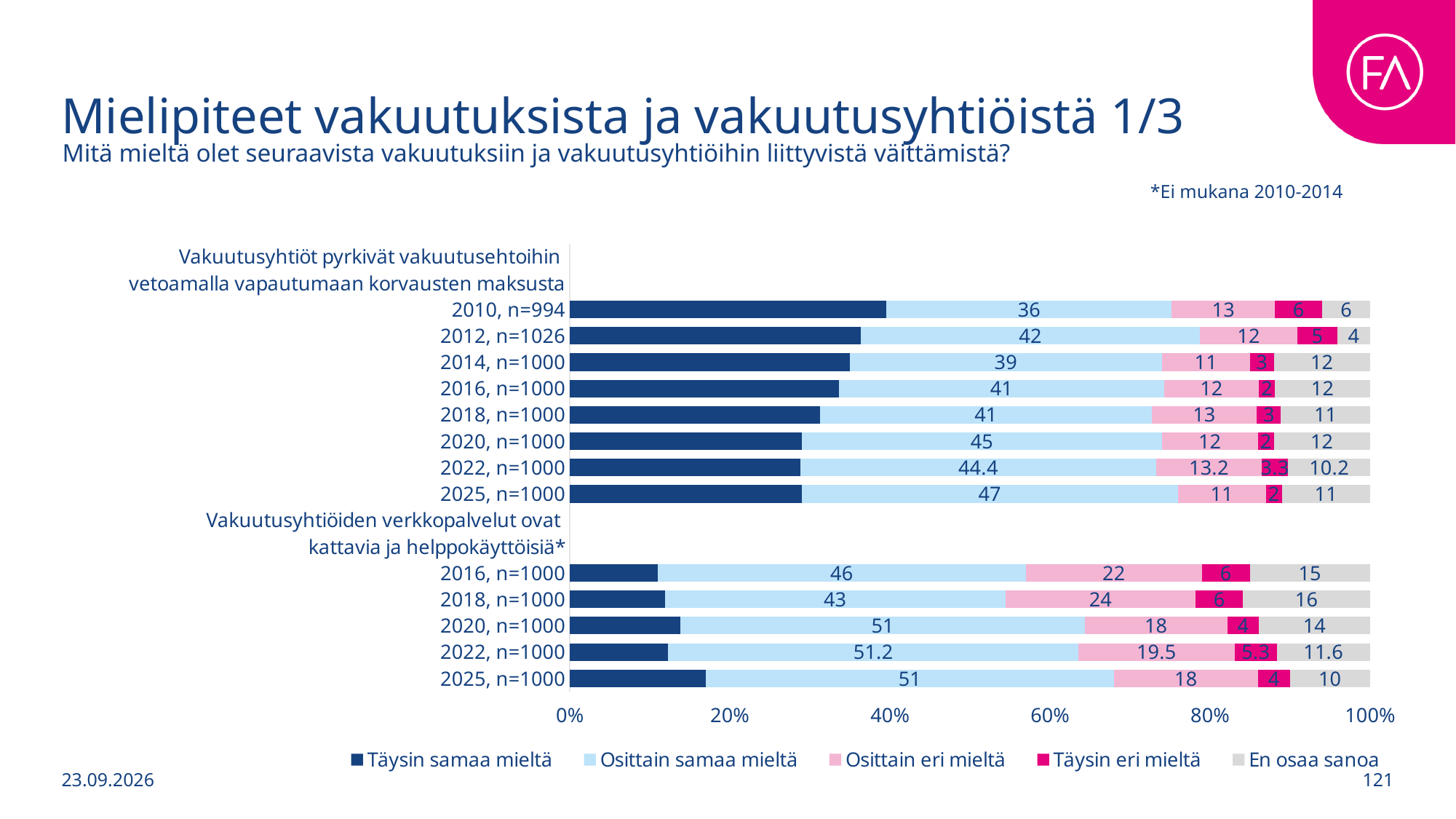
Under the statement 'Vakuutusyhtiöiden verkkopalvelut ovat kattavia ja helppokäyttöisiä*', what is the difference between the 'Osittain eri mieltä' values for 2018 and 2025? 6 What is the 'Osittain eri mieltä' value for 2022, n=1000 under the statement 'Vakuutusyhtiöiden verkkopalvelut ovat kattavia ja helppokäyttöisiä*'? 19.5 Is the 'Täysin samaa mieltä' value for 2010, n=994 under the first statement greater or less than 20%? greater Under the statement 'Vakuutusyhtiöt pyrkivät vakuutusehtoihin vetoamalla vapautumaan korvausten maksusta', which year has the lowest 'En osaa sanoa' value? 2012, n=1026 What is the value of 'Osittain samaa mieltä' for 2025, n=1000 under the statement 'Vakuutusyhtiöt pyrkivät vakuutusehtoihin vetoamalla vapautumaan korvausten maksusta'? 47 How many series does the legend list? 5 Under the statement 'Vakuutusyhtiöt pyrkivät vakuutusehtoihin vetoamalla vapautumaan korvausten maksusta', which year has the larger 'Osittain samaa mieltä' value, 2012 or 2014? 2012, n=1026 Under the statement 'Vakuutusyhtiöt pyrkivät vakuutusehtoihin vetoamalla vapautumaan korvausten maksusta', does the 'Osittain samaa mieltä' value generally rise or fall from 2010 to 2025? rise How many bars are plotted in the chart in total? 13 Under the statement 'Vakuutusyhtiöiden verkkopalvelut ovat kattavia ja helppokäyttöisiä*', which year has the highest 'Osittain eri mieltä' value? 2018, n=1000 What is the 'En osaa sanoa' value for 2018, n=1000 under the statement 'Vakuutusyhtiöiden verkkopalvelut ovat kattavia ja helppokäyttöisiä*'? 16 What is the 'Täysin eri mieltä' value for 2022, n=1000 under the statement 'Vakuutusyhtiöt pyrkivät vakuutusehtoihin vetoamalla vapautumaan korvausten maksusta'? 3.3